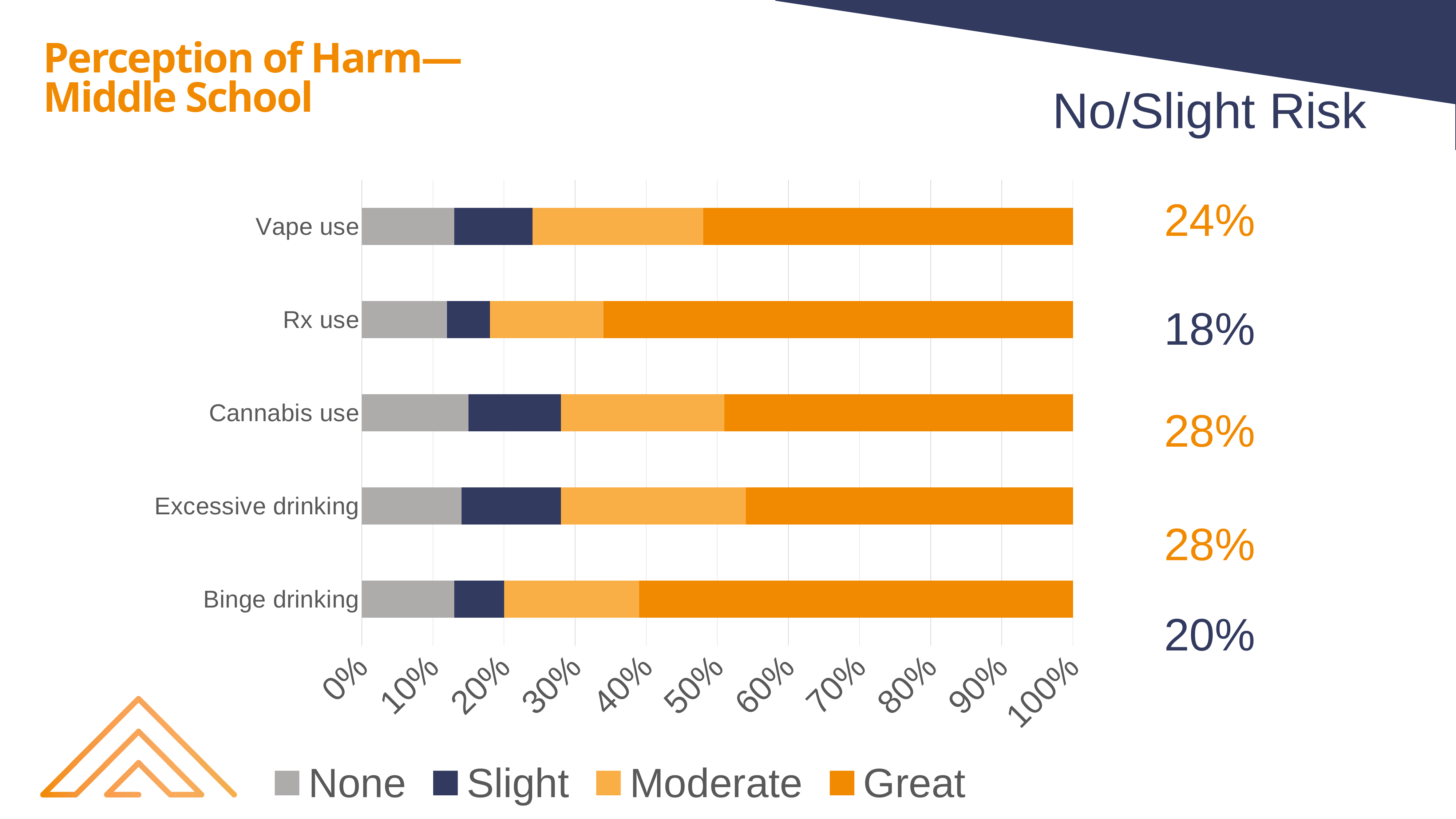
How many series does the legend list? 4 Which is larger, the Slight segment for Cannabis use or the Slight segment for Rx use? Cannabis use What is the No/Slight Risk percentage shown for Rx use? 18% What is the No/Slight Risk percentage shown for Vape use? 24% Is the Great value for Rx use greater or less than 60%? greater Is the Great value for Binge drinking greater or less than 50%? greater How many categories are plotted on the chart? 5 What is the No/Slight Risk percentage shown for Binge drinking? 20% Which category has the smallest Slight segment? Rx use What are the four legend entries, in order? None, Slight, Moderate, Great Which category has the largest Great segment? Rx use What kind of chart is shown on the slide? stacked bar chart